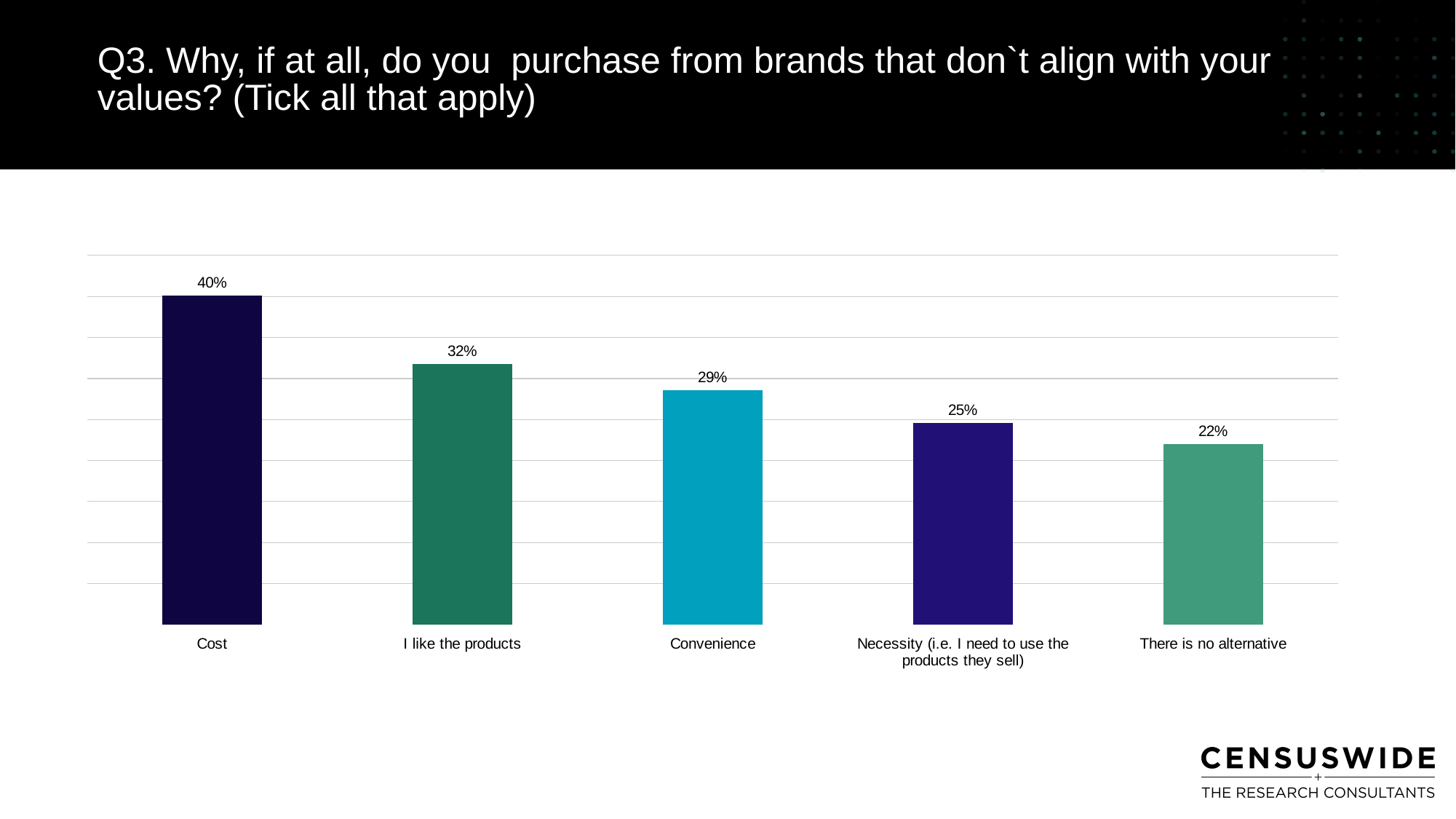
What is the difference in percentage points between Cost and 'There is no alternative'? 18 What is the difference between 'I like the products' and Convenience? 3 Do the values rise or fall moving from left to right across the categories? Fall What type of chart is shown on the slide? Bar chart What percentage of respondents selected Cost as a reason for purchasing from brands that don't align with their values? 40% Which is larger: Convenience or Necessity (i.e. I need to use the products they sell)? Convenience Which reason has the highest percentage? Cost What is the value for 'There is no alternative'? 22% How many reasons (categories) are shown in the chart? 5 What is the value shown for 'I like the products'? 32% What percentage is shown for Convenience? 29% Which reason has the lowest percentage? There is no alternative